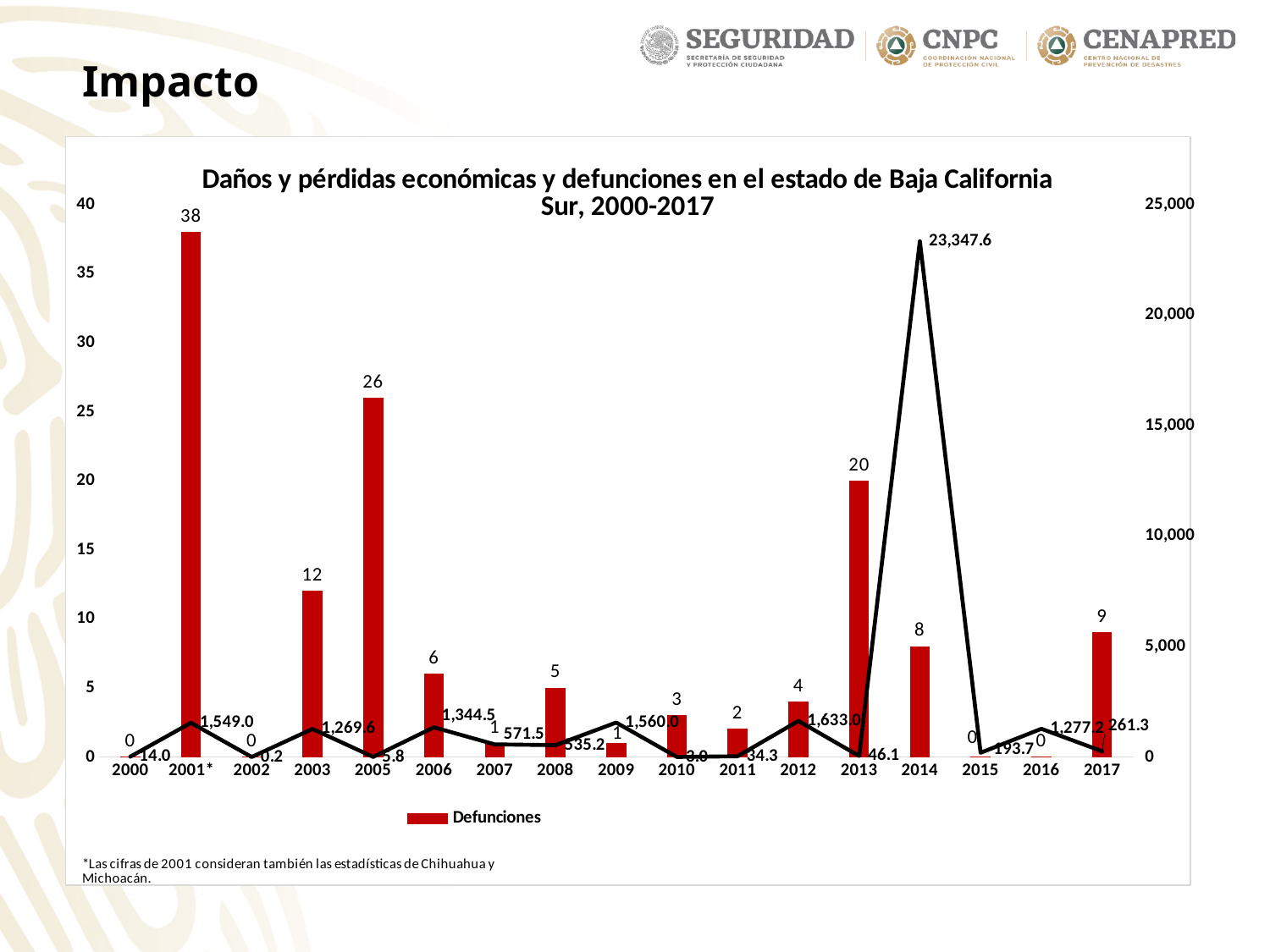
How many years are shown on the x axis? 17 Is the line value for 2014 greater or less than 20,000 on the right axis? greater What is the difference in deaths between 2001* and 2005? 12 Which year has more deaths, 2003 or 2014? 2003 What is the value of the line series (economic damages) for 2014? 23,347.6 What is the value of the line series (economic damages) for 2007? 571.5 How many deaths (Defunciones) are shown for 2001*? 38 Which year has the highest number of deaths (Defunciones)? 2001* What kind of chart is this? A bar chart combined with a line chart How many deaths (Defunciones) are shown for 2013? 20 How many series does the legend list? 1 In which year does the line series (economic damages) reach its highest value? 2014